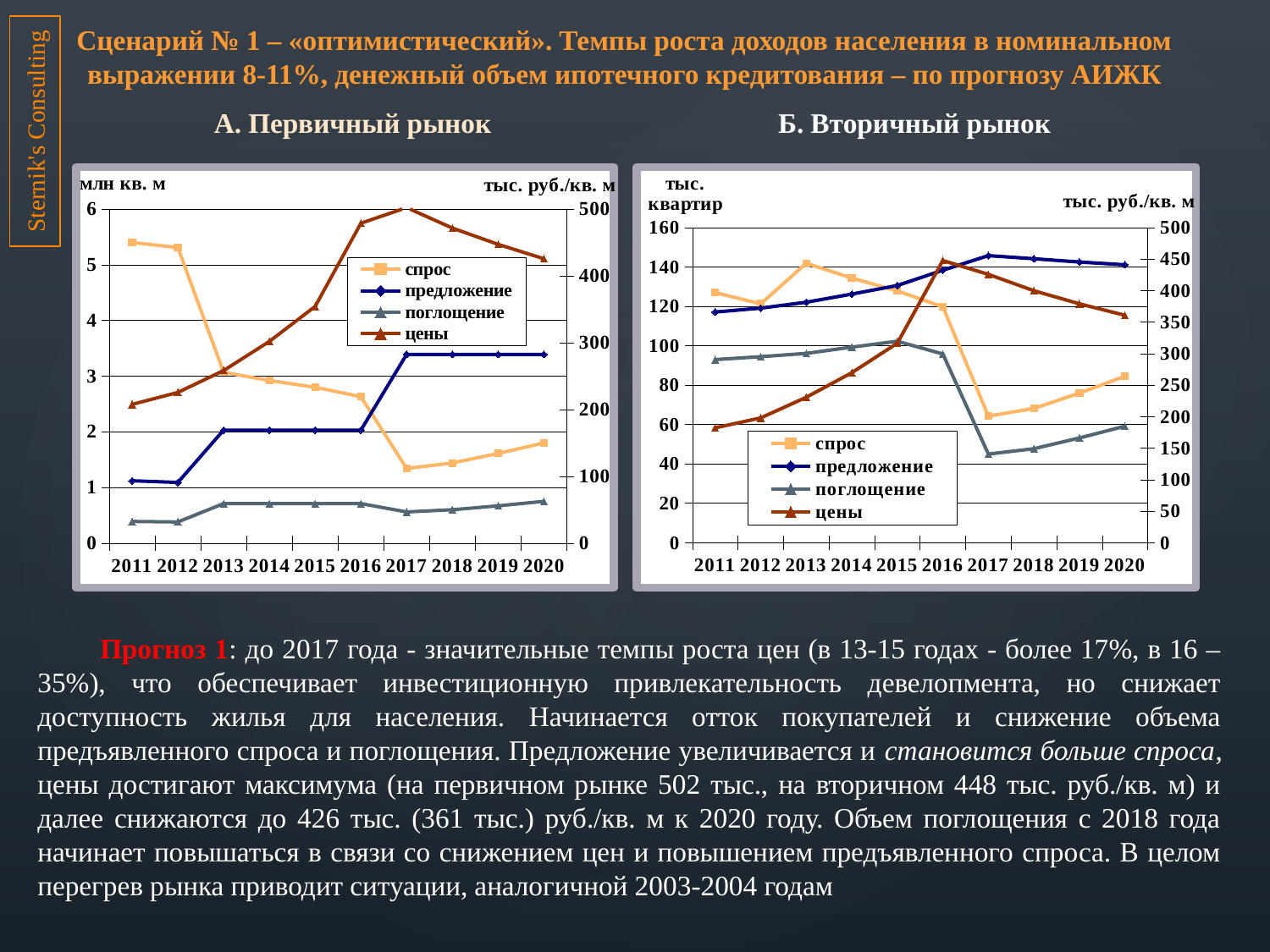
How many series does the legend of the «А. Первичный рынок» chart list? 4 In the «Б. Вторичный рынок» chart, is the value for спрос in 2017 greater or less than 80? less In the «А. Первичный рынок» chart, is the value for спрос in 2011 greater or less than 5? greater In the «А. Первичный рынок» chart, which is larger in 2020: спрос or предложение? предложение In the «А. Первичный рынок» chart, in which year do цены reach their highest value? 2017 In the «А. Первичный рынок» chart, does предложение rise or fall from 2011 to 2020? rises What kind of chart is used for «А. Первичный рынок»? line chart In the «Б. Вторичный рынок» chart, in which year is спрос highest? 2013 In the «Б. Вторичный рынок» chart, in which year do цены reach their highest value? 2016 How many years are shown on the x axis of the «Б. Вторичный рынок» chart? 10 In the «А. Первичный рынок» chart, is the value for предложение in 2011 greater or less than 2? less In the «Б. Вторичный рынок» chart, in which year is поглощение lowest? 2017